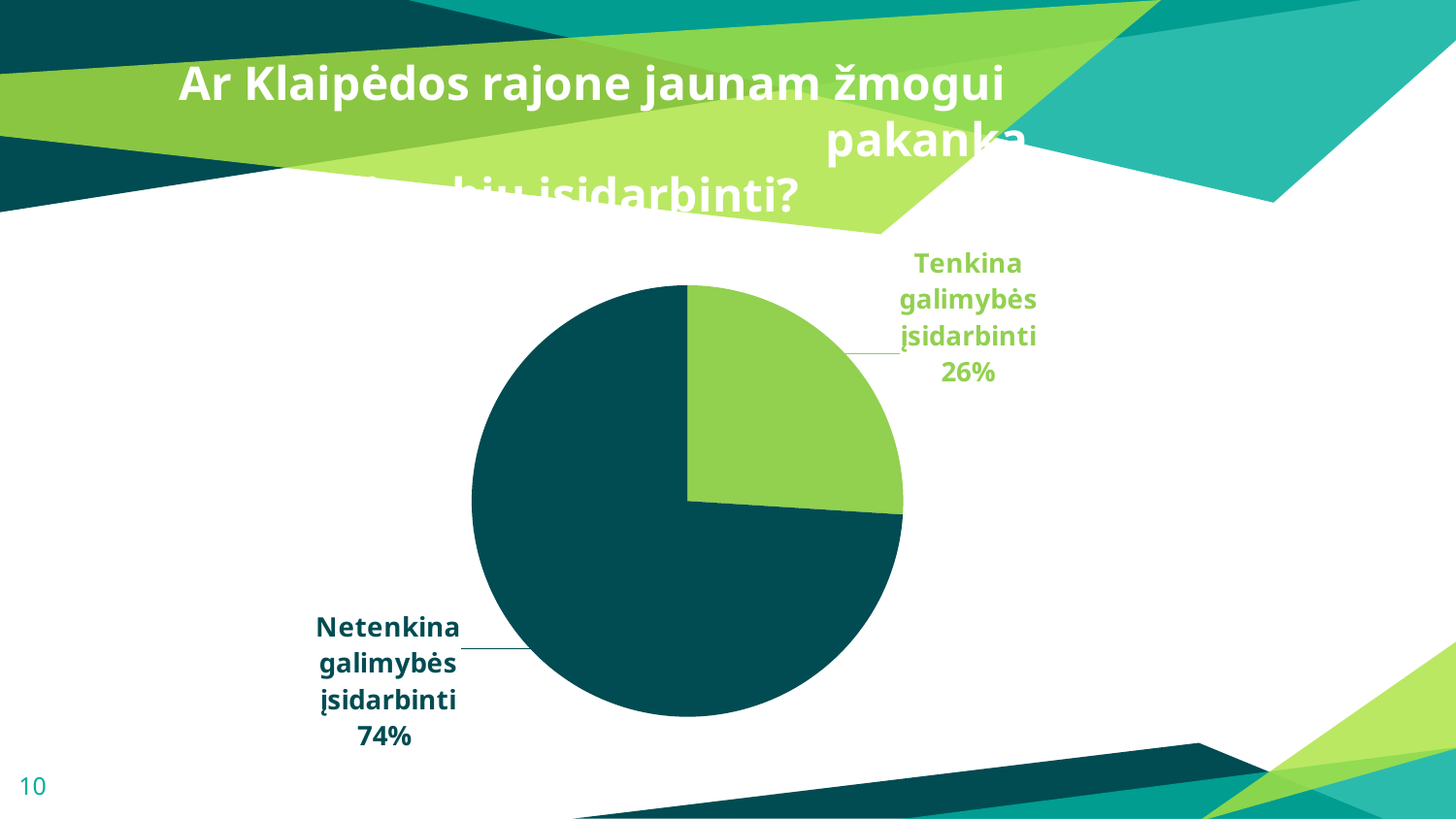
Which slice of the pie is the largest? Netenkina galimybės įsidarbinti What share of the pie is labelled "Netenkina galimybės įsidarbinti"? 74% Which slice of the pie is the smallest? Tenkina galimybės įsidarbinti Which is larger: the "Tenkina galimybės įsidarbinti" slice or the "Netenkina galimybės įsidarbinti" slice? Netenkina galimybės įsidarbinti What colour is the "Netenkina galimybės įsidarbinti" slice? dark teal How many slices does the pie chart have? 2 What is the difference in percentage points between the "Netenkina galimybės įsidarbinti" slice and the "Tenkina galimybės įsidarbinti" slice? 48 What colour is the "Tenkina galimybės įsidarbinti" slice? light green What share of the pie is labelled "Tenkina galimybės įsidarbinti"? 26% What is the total of the two slice percentages shown on the pie chart? 100% What kind of chart is shown on the slide? pie chart